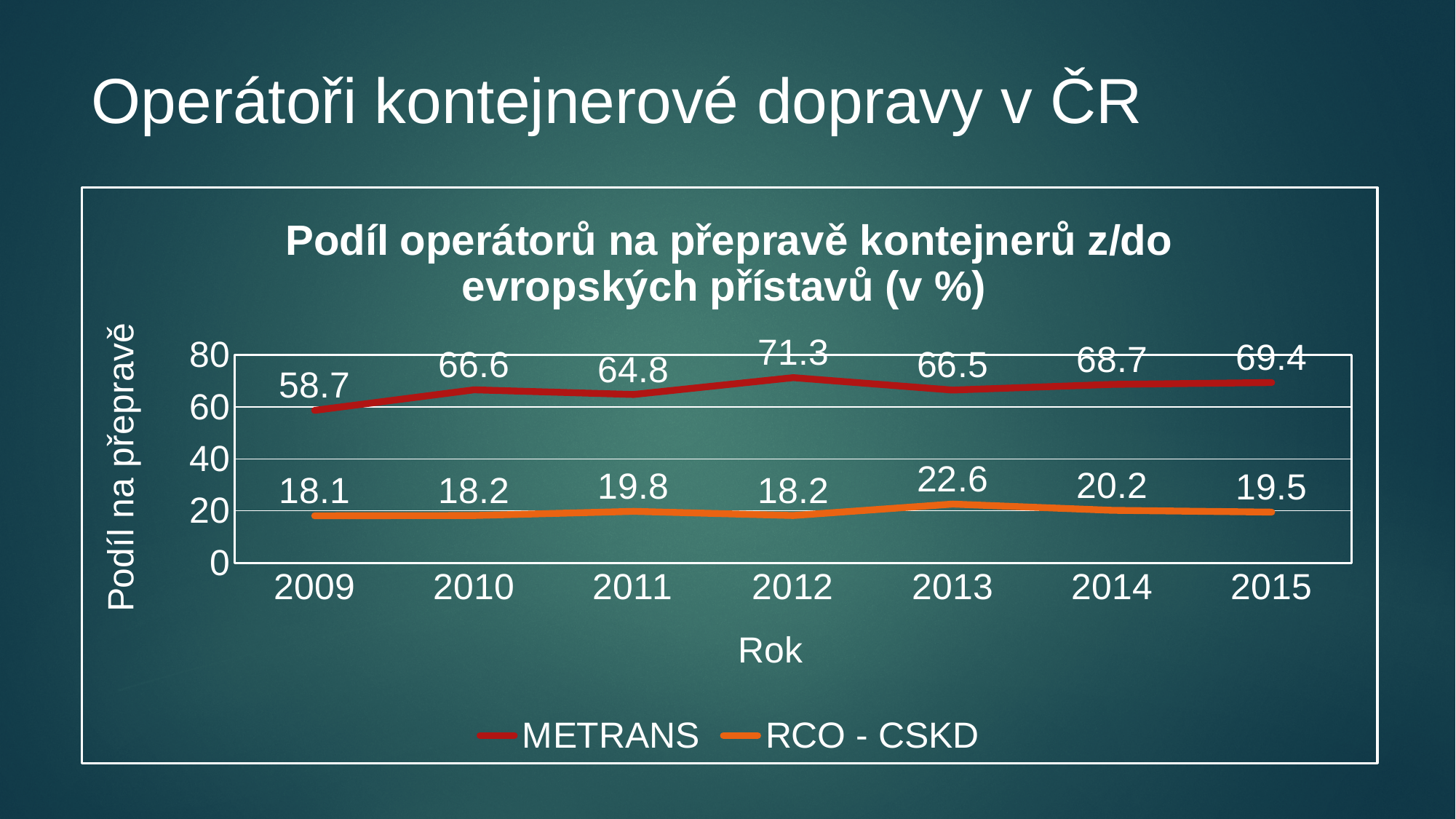
What kind of chart is shown? line chart In which year is the RCO - CSKD value lowest? 2009 What is the value for METRANS in 2009? 58.7 How many series does the legend list? 2 What is the value for METRANS in 2012? 71.3 What is the value for RCO - CSKD in 2013? 22.6 Which series has the larger value in 2011, METRANS or RCO - CSKD? METRANS Is the value for METRANS in 2009 greater or less than 40? greater How many years are shown on the x axis? 7 What is the label of the y axis? Podíl na přepravě In which year is the METRANS value highest? 2012 What is the difference between the METRANS and RCO - CSKD values in 2015? 49.9